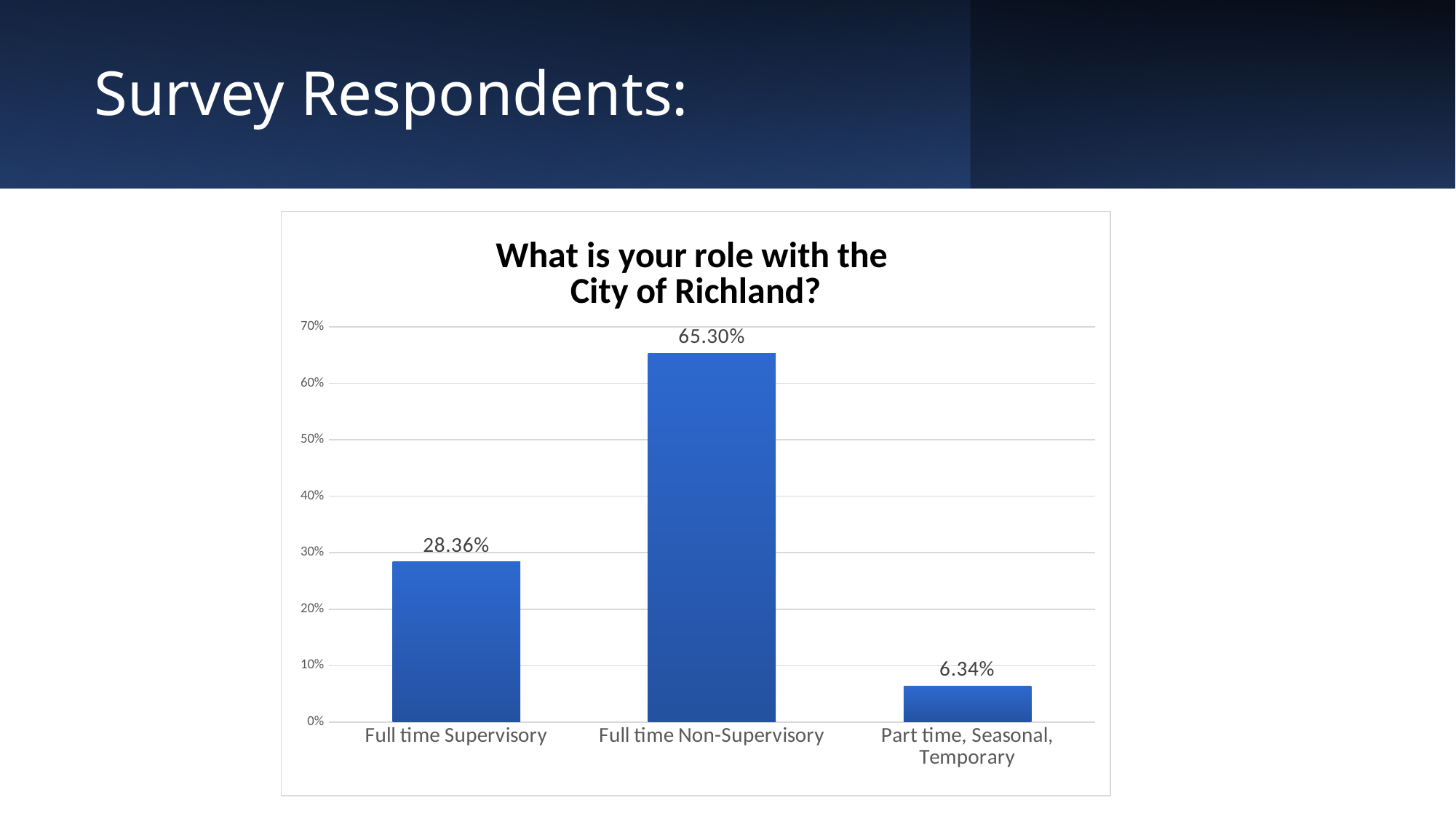
What is the value for Full time Non-Supervisory? 65.30% What is the value for Full time Supervisory? 28.36% What is the difference between the values for Full time Supervisory and Part time, Seasonal, Temporary? 22.02% What kind of chart is shown on the slide? bar chart What is the difference between the values for Full time Non-Supervisory and Full time Supervisory? 36.94% Which category has the lowest value? Part time, Seasonal, Temporary What is the title of the chart? What is your role with the City of Richland? How many categories are shown in the chart? 3 Which is larger, the value for Full time Supervisory or the value for Part time, Seasonal, Temporary? Full time Supervisory Is the value for Full time Non-Supervisory greater or less than 60%? greater What is the value for Part time, Seasonal, Temporary? 6.34% Which category has the highest value? Full time Non-Supervisory